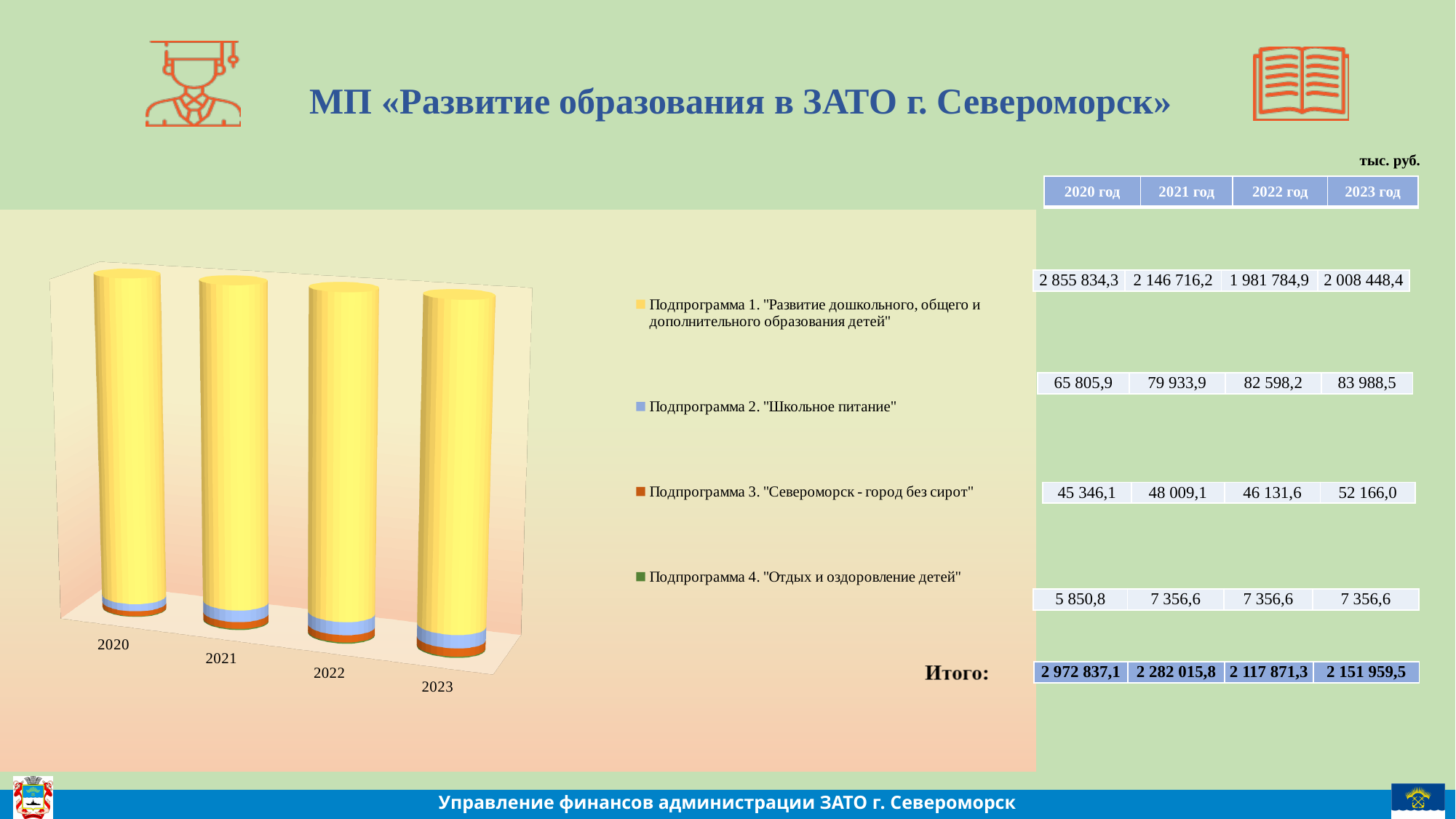
Which is larger: the value for Подпрограмма 3 in 2023 год or in 2021 год? 2023 год What is the total (Итого) for 2021 год? 2 282 015,8 What is the value for Подпрограмма 2 "Школьное питание" in 2023 год? 83 988,5 What is the difference between the values for Подпрограмма 2 "Школьное питание" in 2021 год and 2020 год? 14 128,0 How many series does the chart legend list? 4 Which year has the lowest total (Итого)? 2022 год How many years (categories) are shown on the x axis of the chart? 4 What kind of chart is shown on the slide? bar chart What is the value for Подпрограмма 3 "Североморск - город без сирот" in 2022 год? 46 131,6 What is the value for Подпрограмма 4 "Отдых и оздоровление детей" in 2020 год? 5 850,8 Which year has the highest total (Итого)? 2020 год What is the value for Подпрограмма 1 "Развитие дошкольного, общего и дополнительного образования детей" in 2020 год? 2 855 834,3